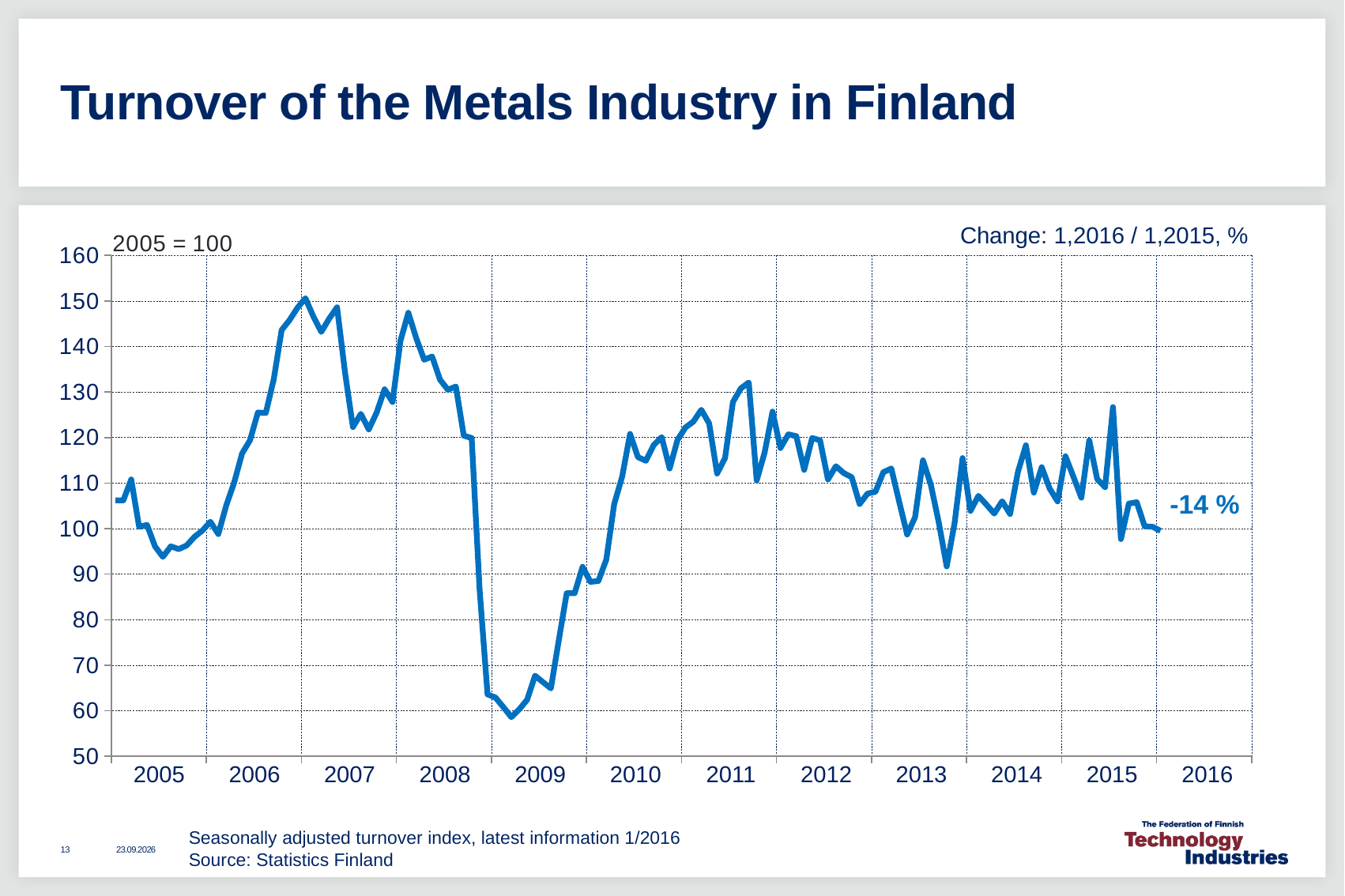
In which year does the turnover index reach its highest point? 2007 Is the value of the index at the start of 2005 greater or less than 100? greater Is the peak value of the index in 2006 greater or less than 140? greater What base year and value is the index set to, as noted on the chart? 2005 = 100 Does the turnover index rise or fall between mid-2008 and early 2009? fall Is the value of the index at the start of 2016 greater or less than 110? less In which year does the turnover index reach its lowest point? 2009 What kind of chart is shown on the slide? line chart Does the turnover index rise or fall between early 2009 and early 2010? rise What is the title of the chart on the slide? Turnover of the Metals Industry in Finland What percentage change is annotated at the right end of the line? -14 %